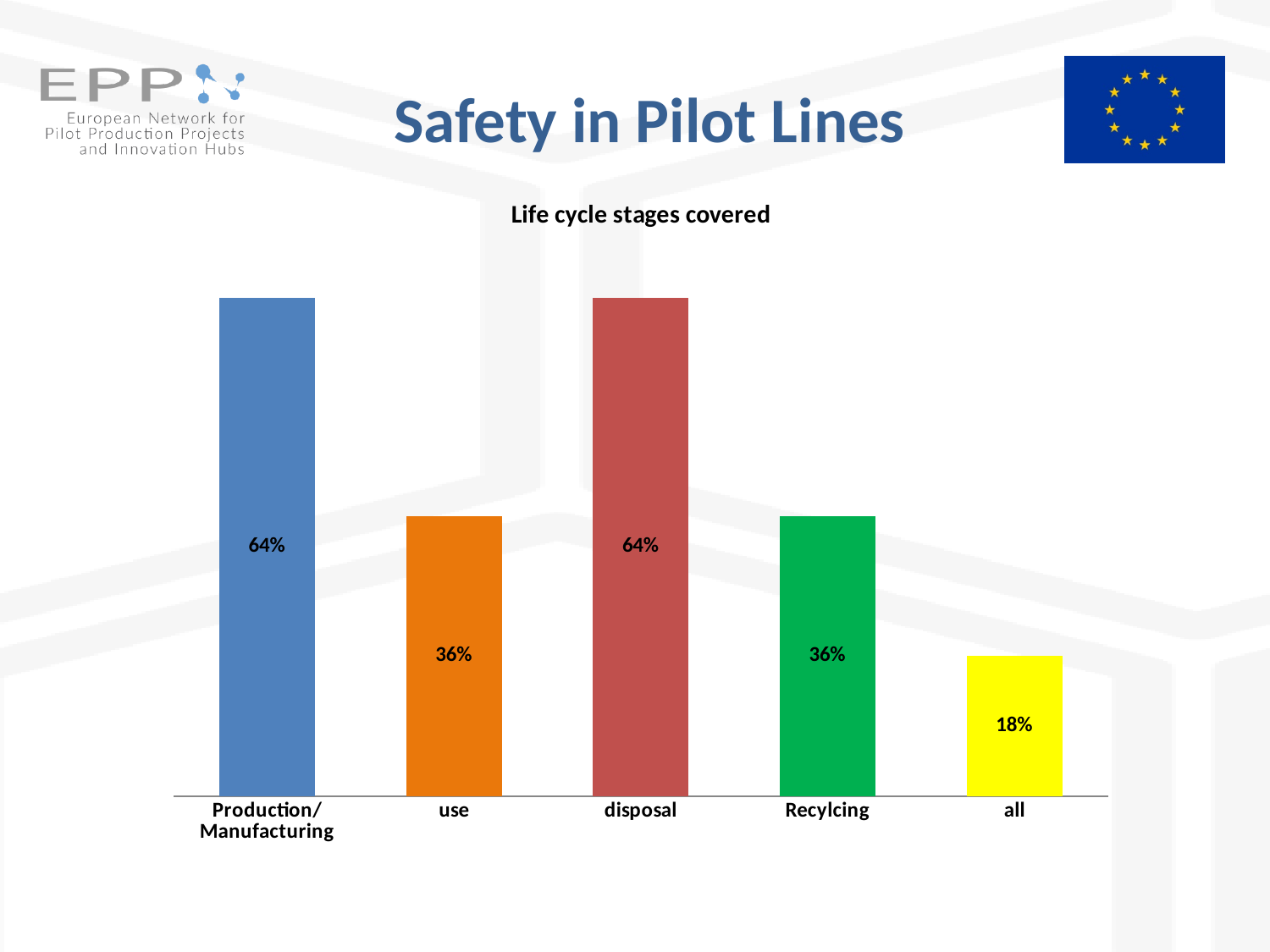
What is the value for Recylcing? 36% What is the title of the chart? Life cycle stages covered What is the value for Production/Manufacturing? 64% How many categories are shown on the x axis? 5 Which category has the lowest value? all What is the difference between the values for disposal and all? 46% What is the value for use? 36% What is the value for all? 18% What is the value for disposal? 64% What kind of chart is shown on the slide? bar chart What is the difference between the values for use and all? 18% Which is larger, the value for use or the value for all? use